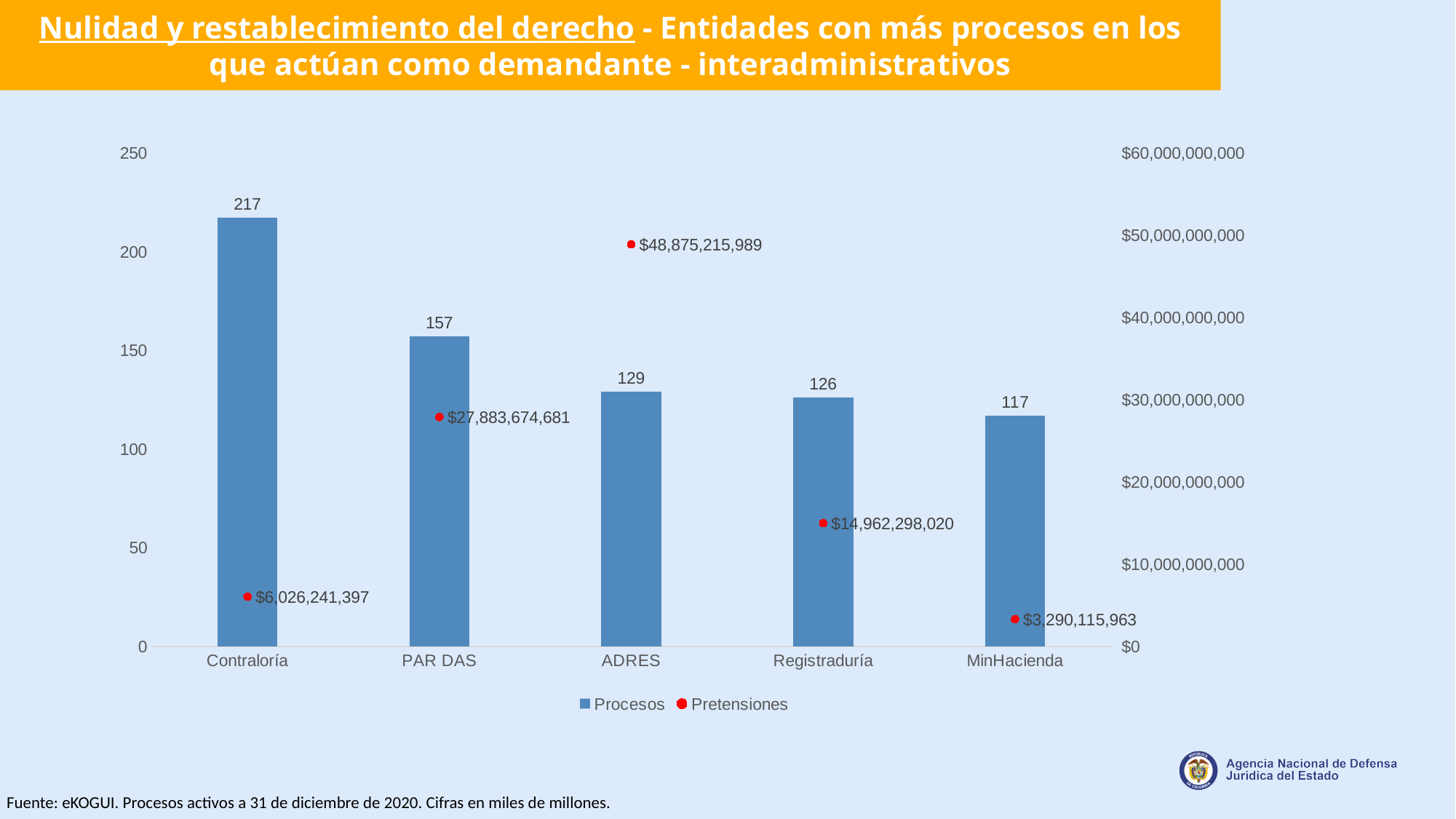
How many series does the legend list? 2 How many entities are shown on the x axis? 5 Which entity has the highest Pretensiones value? ADRES What kind of chart is used to show the Procesos series? Bar chart Do the Procesos values rise or fall from left to right along the x axis? Fall Which entity has the highest number of Procesos? Contraloría How many Procesos does Contraloría have? 217 What is the Pretensiones value for ADRES? $48,875,215,989 Which has more Procesos, ADRES or Registraduría? ADRES What is the Pretensiones value for MinHacienda? $3,290,115,963 Which entity has the lowest Pretensiones value? MinHacienda What is the difference in Procesos between Contraloría and PAR DAS? 60